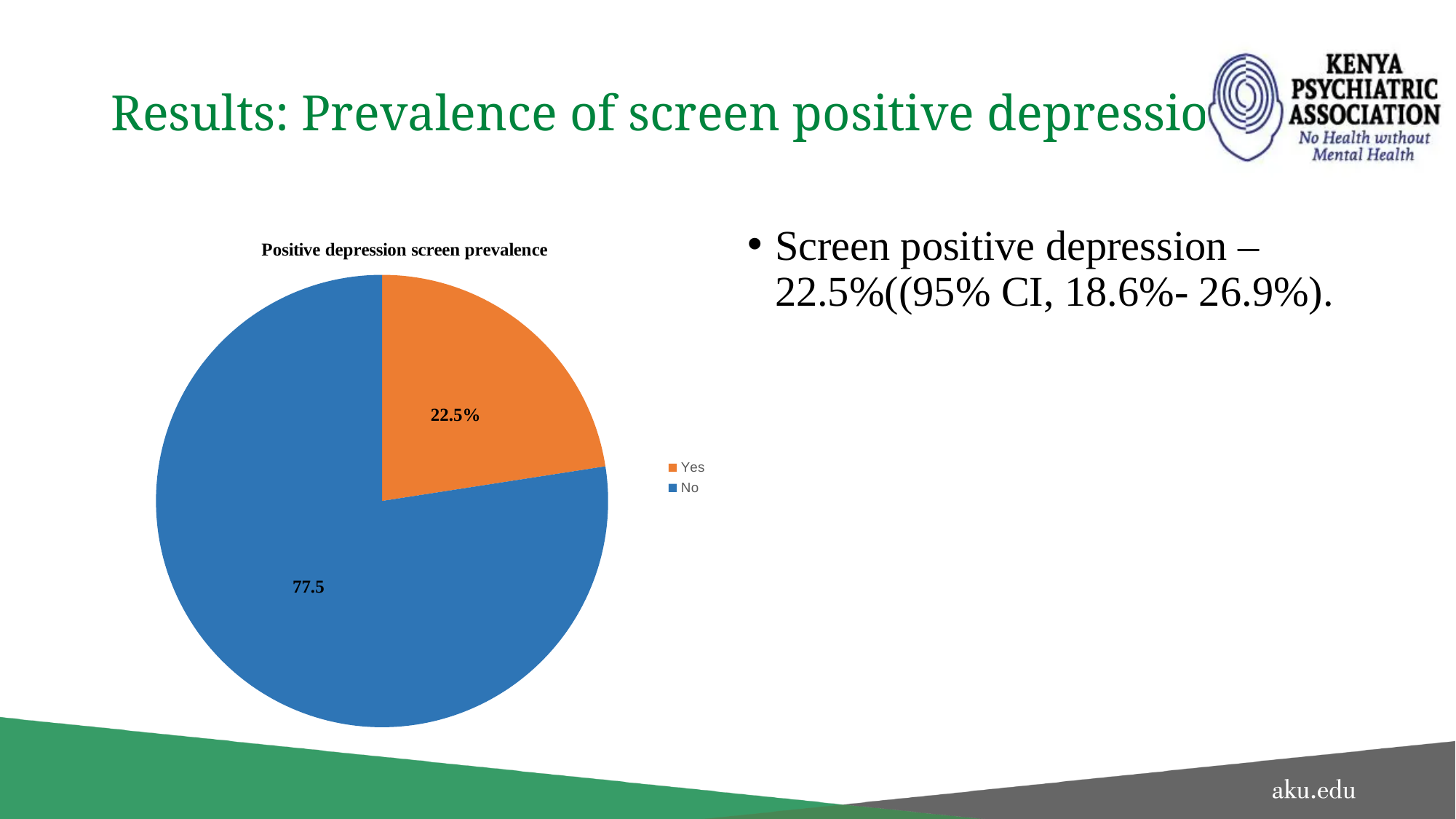
What value is shown for the No slice? 77.5 What is the title of the chart? Positive depression screen prevalence What value is shown for the Yes slice? 22.5% How many entries does the legend list? 2 Which is larger, the Yes slice or the No slice? No How many slices does the pie chart have? 2 What kind of chart is shown on the slide? Pie chart Which slice is the largest? No What colour is the Yes slice? Orange Which slice is the smallest? Yes What is the difference between the No value and the Yes value? 55